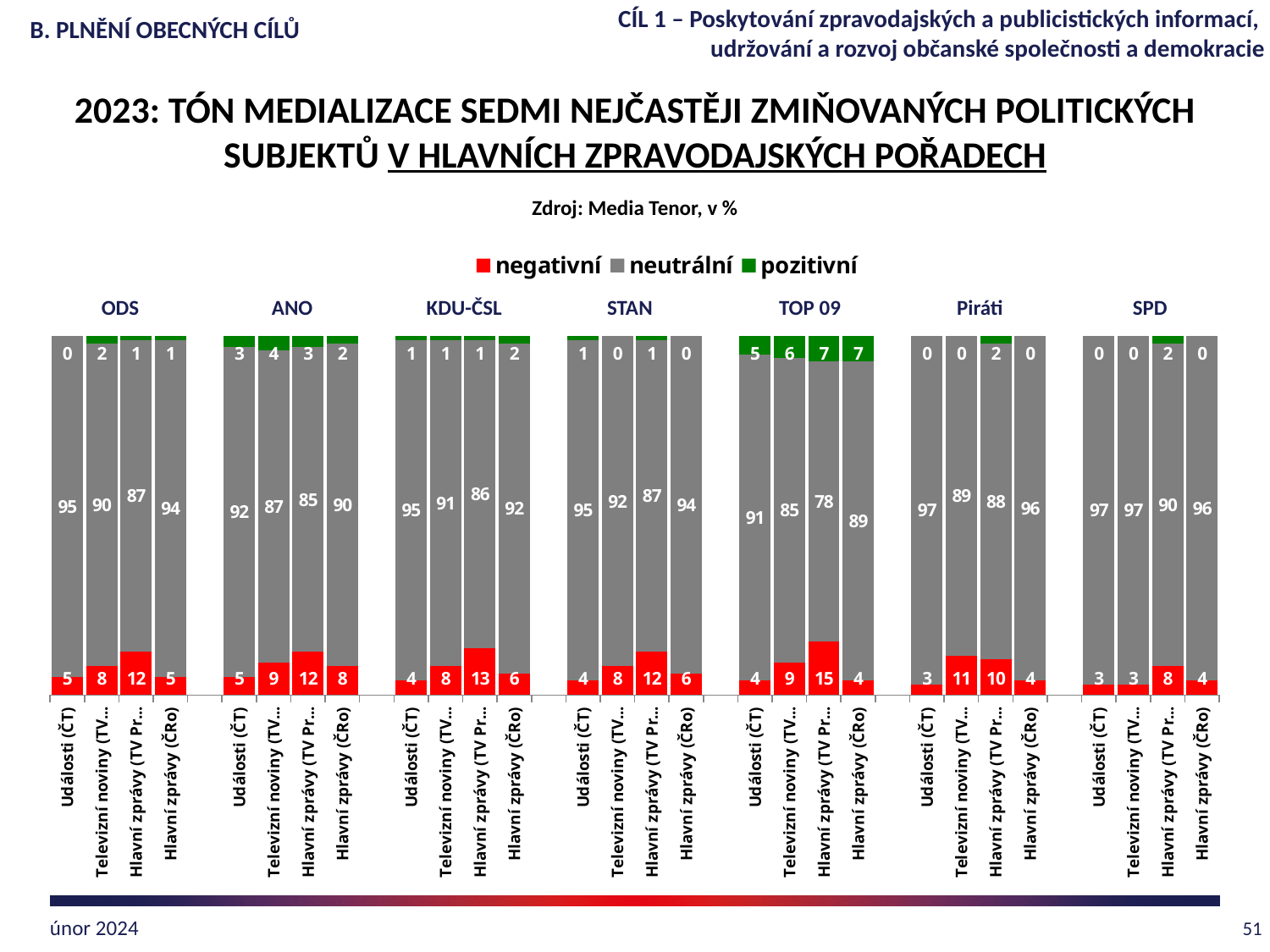
What is the difference between the negativní values for Piráti in Televizní noviny and in Události (ČT)? 8 Which colour represents the negativní series in the legend? red Which political subject has the lowest neutrální value in Hlavní zprávy (TV Prima)? TOP 09 What is the total of the stacked bar for ODS in Televizní noviny (negativní + neutrální + pozitivní)? 100 Which is larger: the negativní value for KDU-ČSL in Hlavní zprávy (TV Prima) or for STAN in Hlavní zprávy (TV Prima)? KDU-ČSL How many series does the legend list? 3 What kind of chart is shown on the slide? stacked bar chart What is the pozitivní value for ANO in Televizní noviny? 4 Which political subject has the highest pozitivní value in Hlavní zprávy (ČRo)? TOP 09 What is the neutrální value for SPD in Události (ČT)? 97 How many political subjects are shown in the chart? 7 What is the negativní value for TOP 09 in Hlavní zprávy (TV Prima)? 15